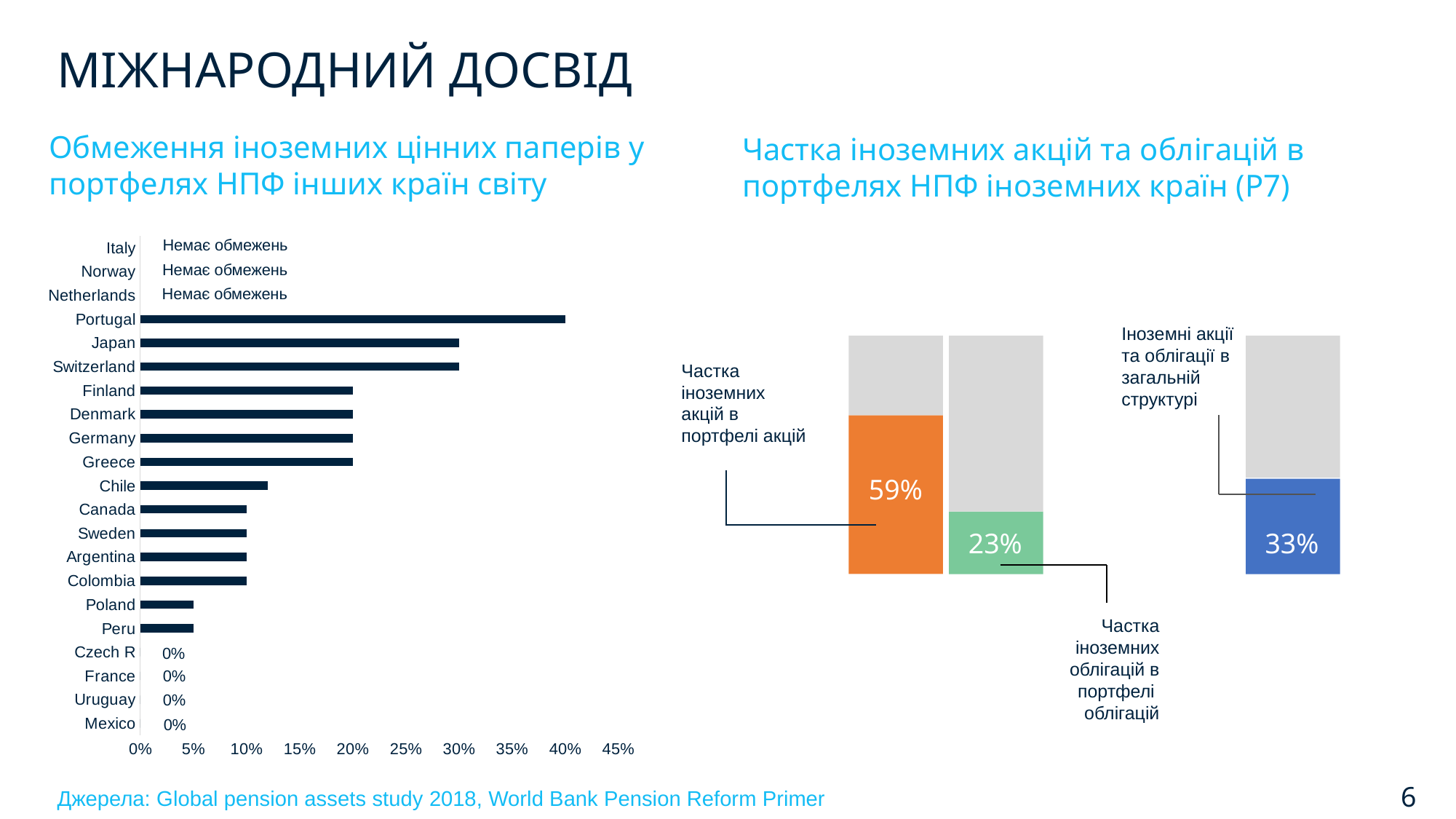
On the left chart, what is the value for Japan? 30% On the left chart, what text is shown next to Italy, Norway and Netherlands instead of a bar? Немає обмежень What kind of chart is the left chart? bar chart On the left chart, what value is shown for Czech R? 0% On the left chart, which country has the highest limit shown as a bar? Portugal On the left chart, is the value for Chile greater or less than 10%? greater On the left chart, what is the value for Portugal? 40% On the left chart, which is larger, the value for Finland or the value for Canada? Finland On the right chart, what is the share of foreign bonds in the bond portfolio (Частка іноземних облігацій в портфелі облігацій)? 23% On the right chart, what is the share of foreign equities in the equity portfolio (Частка іноземних акцій в портфелі акцій)? 59% On the left chart, is the value for Poland greater or less than 10%? less On the right chart, what is the difference between the foreign equities share (59%) and the foreign bonds share (23%)? 36%